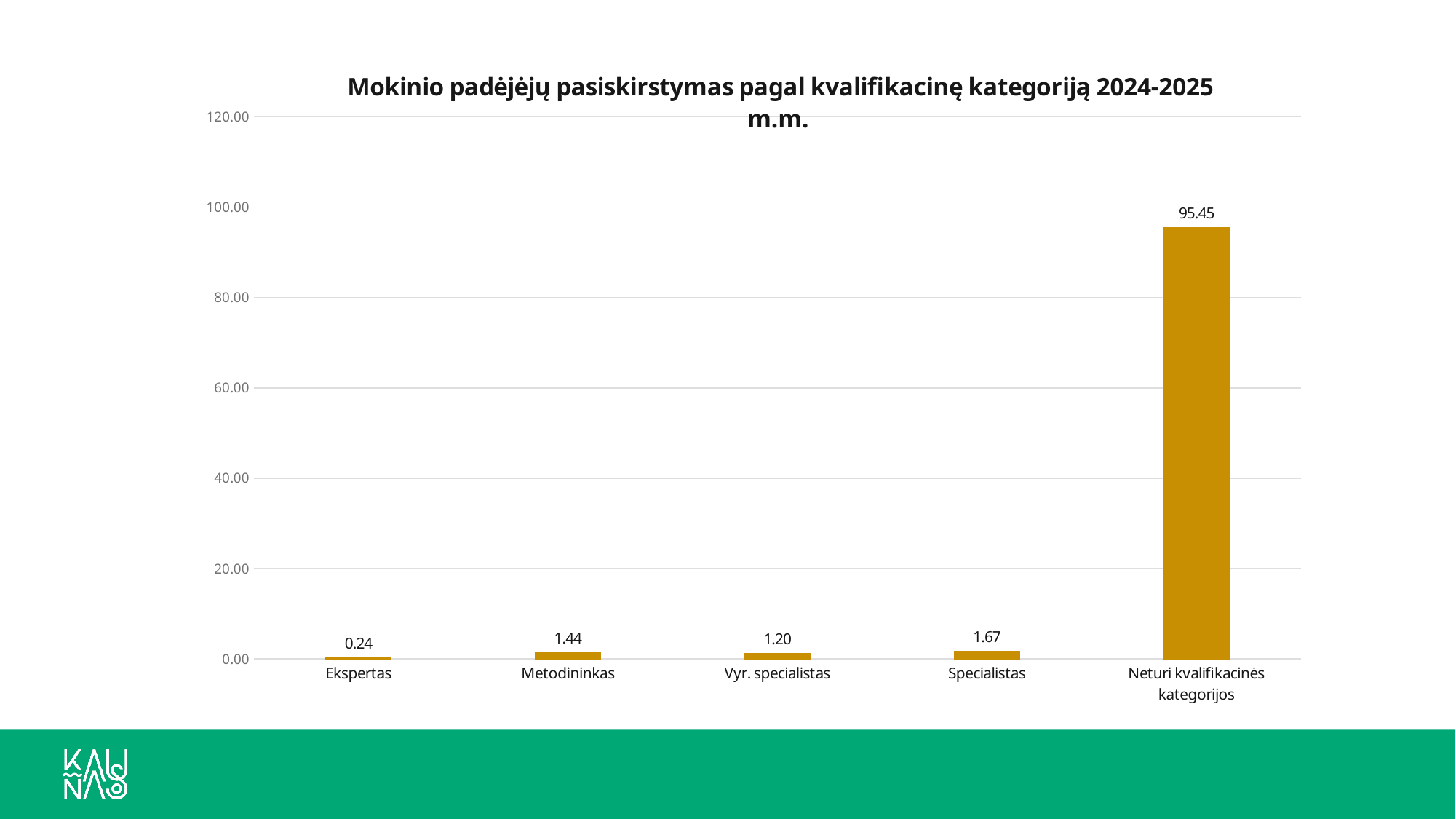
How many categories are shown on the x axis? 5 What is the value for Vyr. specialistas? 1.20 What is the value for Ekspertas? 0.24 Which category has the lowest value? Ekspertas What kind of chart is shown on the slide? bar chart What is the difference between the values for Neturi kvalifikacinės kategorijos and Specialistas? 93.78 What is the value for Neturi kvalifikacinės kategorijos? 95.45 What is the value for Metodininkas? 1.44 Which category has the highest value? Neturi kvalifikacinės kategorijos What is the value for Specialistas? 1.67 Is the value for Neturi kvalifikacinės kategorijos greater or less than 80.00? greater Which is larger, the value for Metodininkas or the value for Vyr. specialistas? Metodininkas